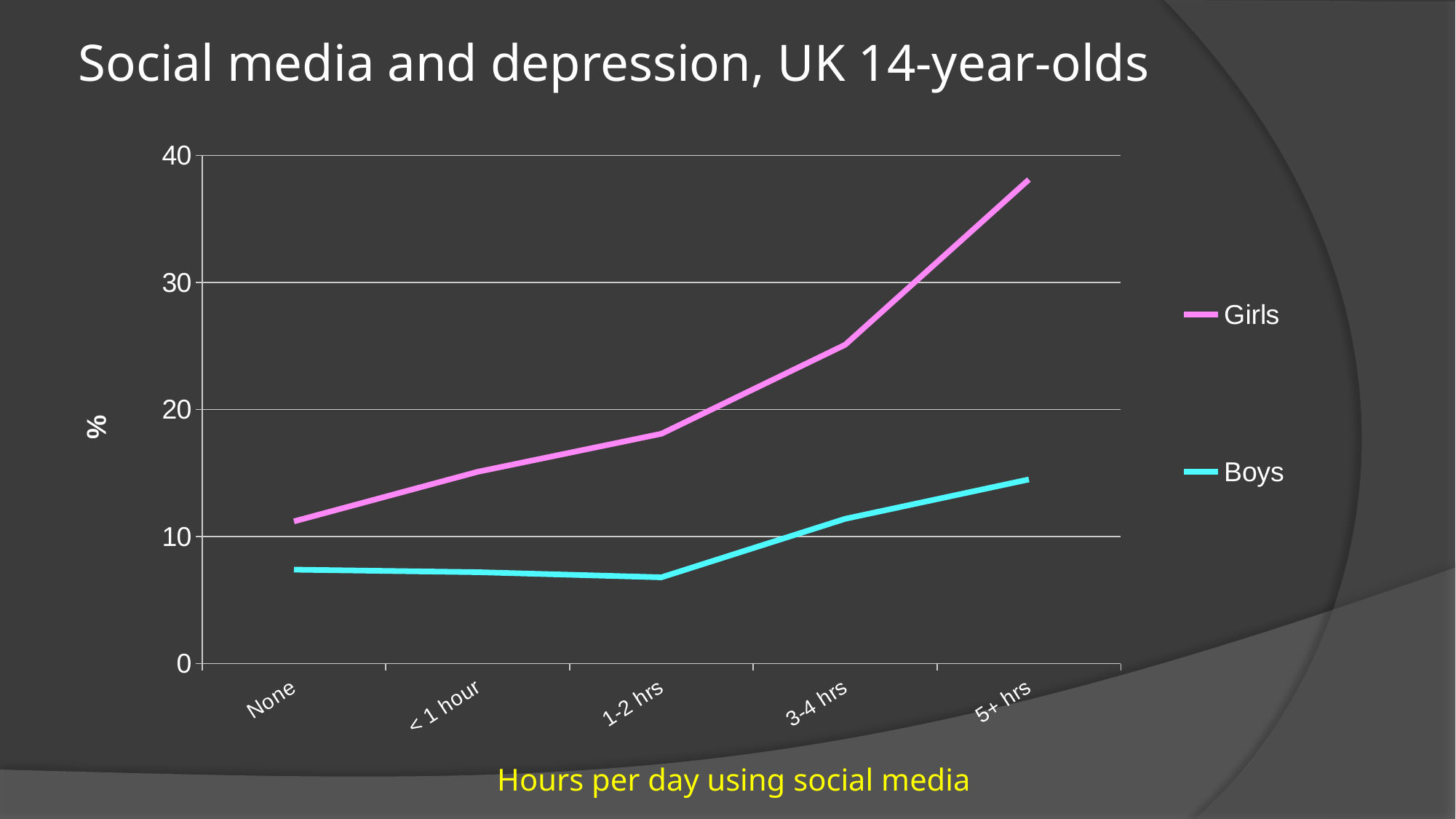
Is the Girls value for 5+ hrs greater or less than 30? greater At which hours-per-day category is the Girls value highest? 5+ hrs Does the Girls line rise or fall as hours per day using social media increase? Rises At which hours-per-day category is the Boys value highest? 5+ hrs Is the Boys value for 5+ hrs greater or less than 10? greater Is the Boys value for 1-2 hrs greater or less than 10? less At which hours-per-day category is the Girls value lowest? None How many series does the legend list? 2 How many categories are shown along the x axis? 5 What kind of chart is shown on the slide? Line chart At 5+ hrs, which series has the larger value, Girls or Boys? Girls